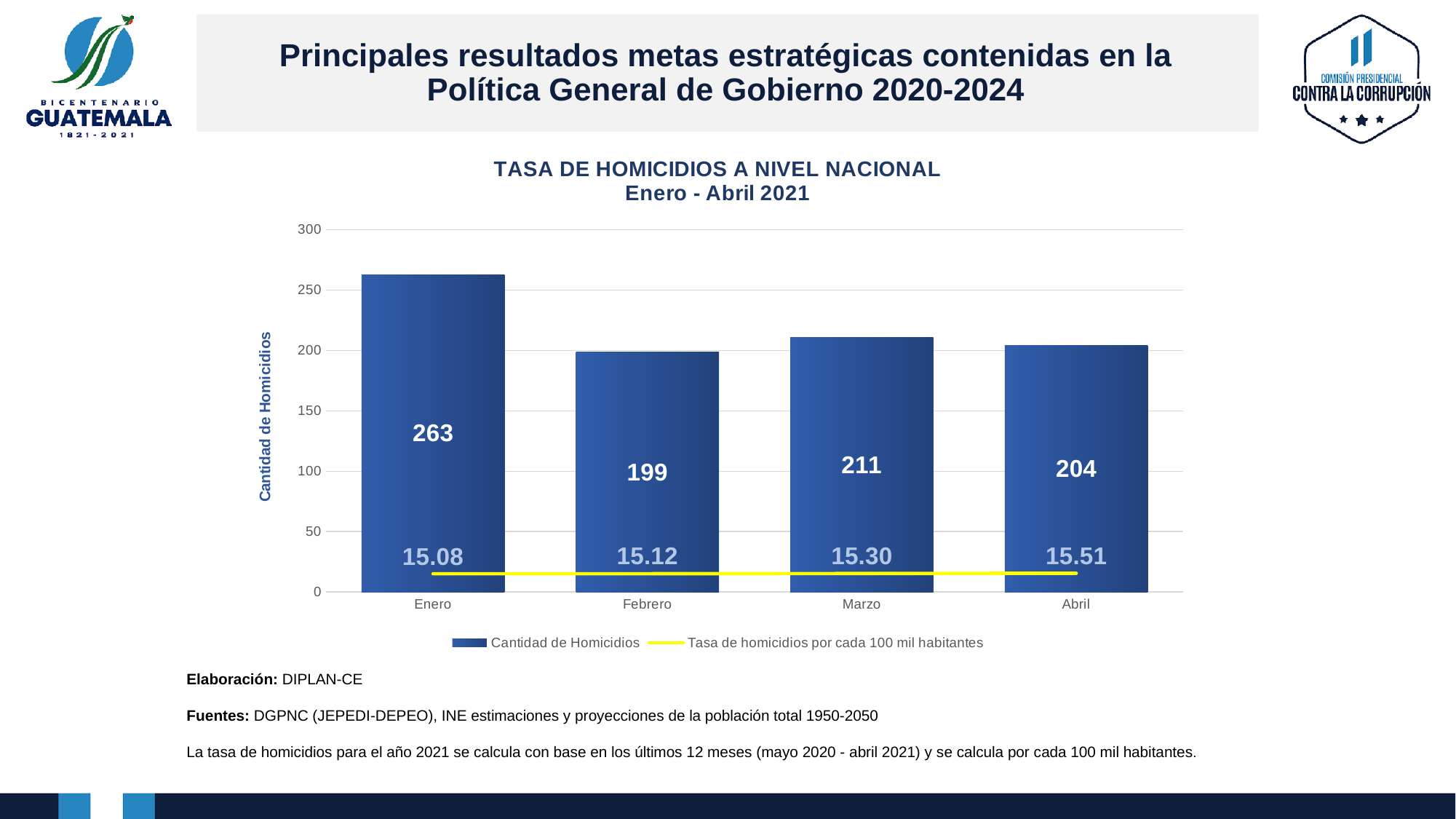
What is the Tasa de homicidios por cada 100 mil habitantes for Abril? 15.51 What is the Cantidad de Homicidios for Marzo? 211 What is the Cantidad de Homicidios for Enero? 263 Which month has the lowest Cantidad de Homicidios? Febrero Does the Tasa de homicidios por cada 100 mil habitantes rise or fall from Enero to Abril? rise What is the title of the chart? TASA DE HOMICIDIOS A NIVEL NACIONAL Enero - Abril 2021 How many months are shown on the x axis? 4 Which month has a higher Cantidad de Homicidios, Marzo or Abril? Marzo Is the Cantidad de Homicidios for Febrero greater or less than 250? less What is the difference in Cantidad de Homicidios between Enero and Febrero? 64 How many series does the legend list? 2 Which month has the highest Cantidad de Homicidios? Enero